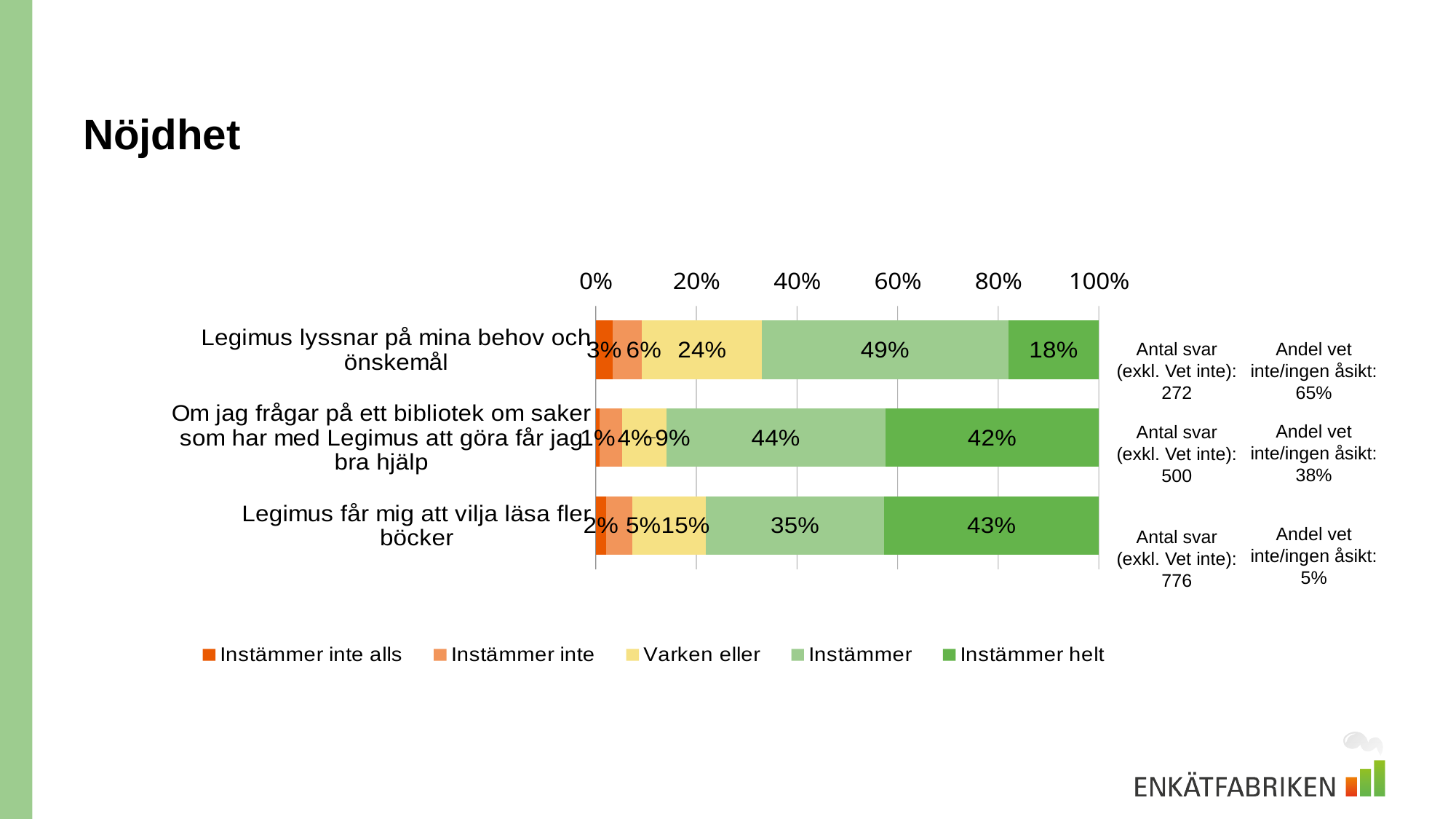
What is the total of the stacked bar for "Legimus får mig att vilja läsa fler böcker"? 100% What is the "Varken eller" value for "Om jag frågar på ett bibliotek om saker som har med Legimus att göra får jag bra hjälp"? 9% What is the "Instämmer helt" value for "Legimus får mig att vilja läsa fler böcker"? 43% Which statement has the lowest "Instämmer inte alls" share? Om jag frågar på ett bibliotek om saker som har med Legimus att göra får jag bra hjälp How many statements (bars) are shown in the chart? 3 For "Legimus lyssnar på mina behov och önskemål", what is the difference between the "Instämmer" and "Instämmer helt" values? 31 percentage points What is the title of the slide? Nöjdhet What percentage of respondents answered "Instämmer" for "Legimus lyssnar på mina behov och önskemål"? 49% What kind of chart is shown on the slide? Stacked bar chart How many series does the legend list? 5 Which is larger: the "Varken eller" share for "Legimus lyssnar på mina behov och önskemål" or for "Legimus får mig att vilja läsa fler böcker"? Legimus lyssnar på mina behov och önskemål Which statement has the highest "Instämmer" share? Legimus lyssnar på mina behov och önskemål